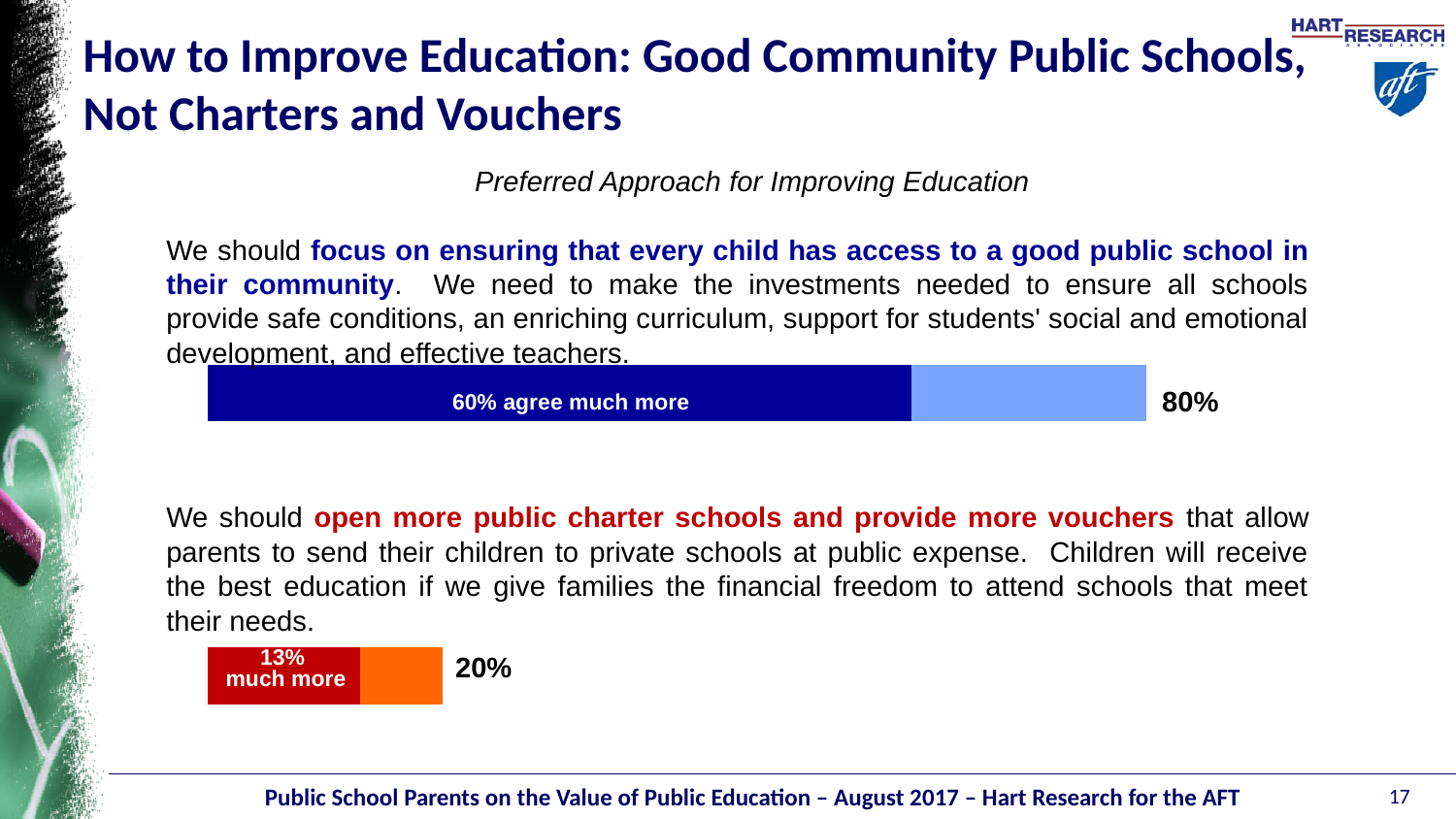
What is the total percentage who agree with opening more public charter schools and providing more vouchers? 20% What is the difference in total agreement between the good community public schools approach (80%) and the charters and vouchers approach (20%)? 60 percentage points What kind of chart is used to show the preferred approach for improving education? Bar chart How many approaches for improving education are shown with bars on the slide? 2 What percentage agree much more with focusing on ensuring every child has access to a good public school in their community? 60% What is the total percentage who agree with the approach of focusing on ensuring every child has access to a good public school in their community? 80% What is the difference between the 'agree much more' shares for the two approaches (60% vs 13%)? 47 percentage points What colour is the 'agree much more' segment of the bar for the good community public schools approach? Dark blue What percentage agree much more with the approach of opening more public charter schools and providing more vouchers? 13% Is the total agreement for the charters and vouchers approach greater or less than 50%? less Which approach has the higher total agreement: good community public schools or charters and vouchers? Good community public schools What is the subtitle of the chart on the slide? Preferred Approach for Improving Education